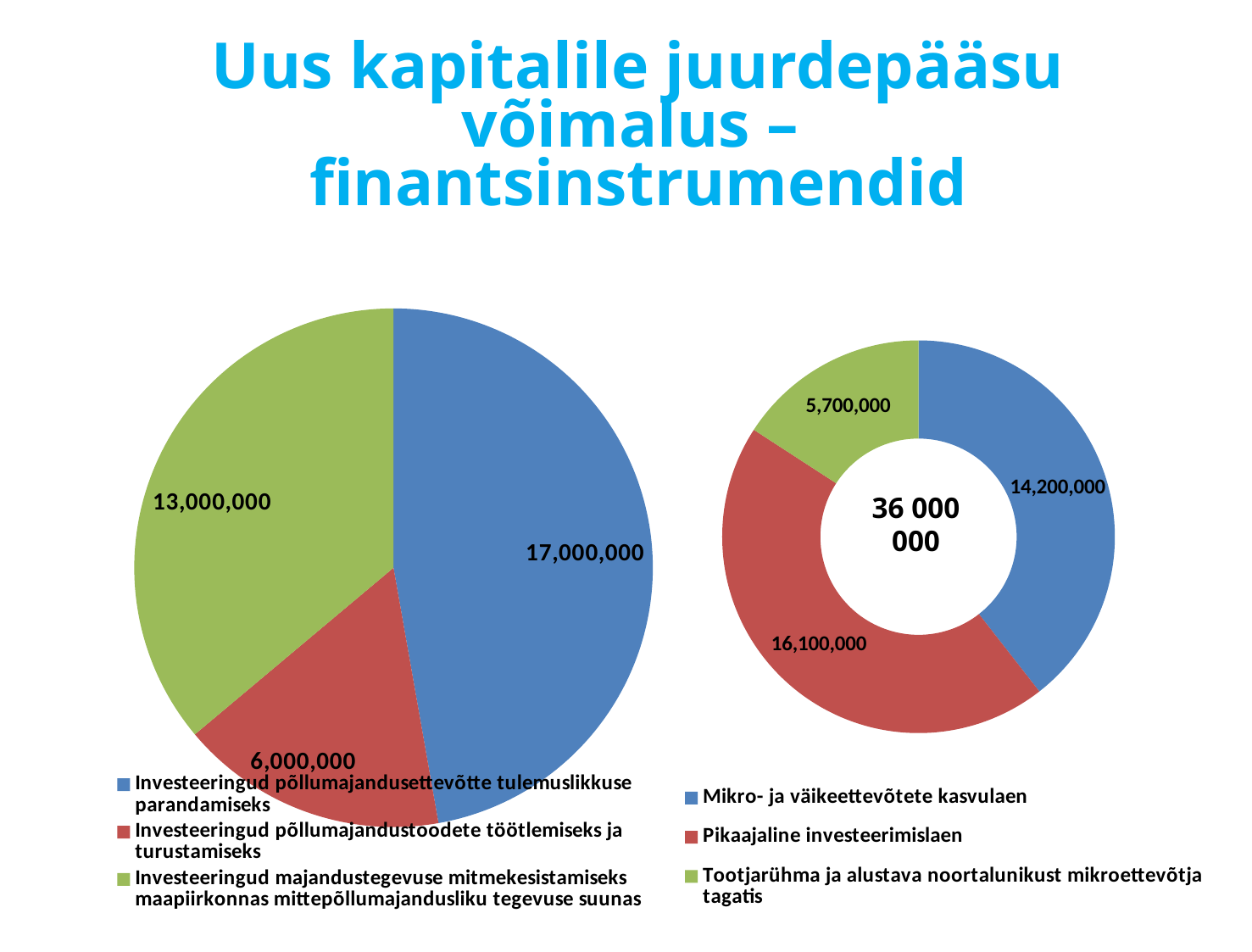
In the doughnut chart on the right, what is the value for 'Pikaajaline investeerimislaen'? 16,100,000 In the doughnut chart on the right, what is the difference between 'Pikaajaline investeerimislaen' and 'Mikro- ja väikeettevõtete kasvulaen'? 1,900,000 What total is shown in the centre of the doughnut chart on the right? 36 000 000 In the pie chart on the left, what is the value for 'Investeeringud põllumajandustoodete töötlemiseks ja turustamiseks'? 6,000,000 In the doughnut chart on the right, which is larger: 'Mikro- ja väikeettevõtete kasvulaen' or 'Tootjarühma ja alustava noortalunikust mikroettevõtja tagatis'? Mikro- ja väikeettevõtete kasvulaen In the pie chart on the left, which category has the largest slice? Investeeringud põllumajandusettevõtte tulemuslikkuse parandamiseks In the pie chart on the left, what is the difference between the values for 'Investeeringud põllumajandusettevõtte tulemuslikkuse parandamiseks' and 'Investeeringud majandustegevuse mitmekesistamiseks maapiirkonnas mittepõllumajandusliku tegevuse suunas'? 4,000,000 In the doughnut chart on the right, which category has the largest value? Pikaajaline investeerimislaen In the pie chart on the left, which category has the smallest slice? Investeeringud põllumajandustoodete töötlemiseks ja turustamiseks In the doughnut chart on the right, what is the value for 'Tootjarühma ja alustava noortalunikust mikroettevõtja tagatis'? 5,700,000 In the pie chart on the left, what is the value for 'Investeeringud põllumajandusettevõtte tulemuslikkuse parandamiseks'? 17,000,000 In the pie chart on the left, how many slices are there? 3